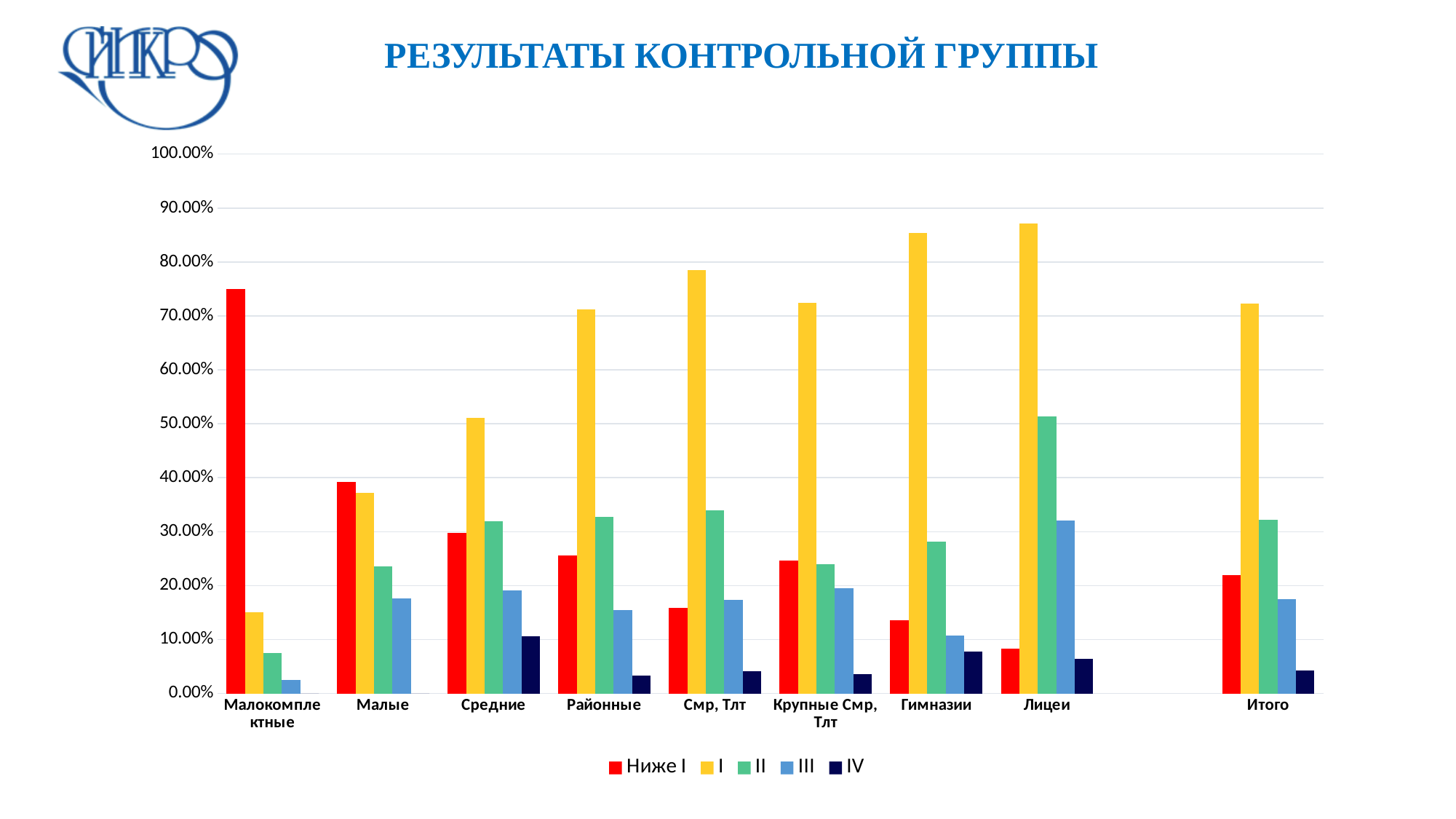
Which series has the highest value in the category Гимназии? I Which category has the highest value for the series "Ниже I"? Малокомплектные What kind of chart is shown on the slide? bar chart For the category Средние, which series has the larger value, "I" or "II"? I Is the value of series "I" for Лицеи greater or less than 80.00%? greater Is the value of series "I" for Итого greater or less than 60.00%? greater How many categories are shown along the x axis? 9 Which series has the lowest value in the category Итого? IV What is the title of the chart? РЕЗУЛЬТАТЫ КОНТРОЛЬНОЙ ГРУППЫ Is the value of series "II" for Лицеи greater or less than 40.00%? greater How many series does the legend list? 5